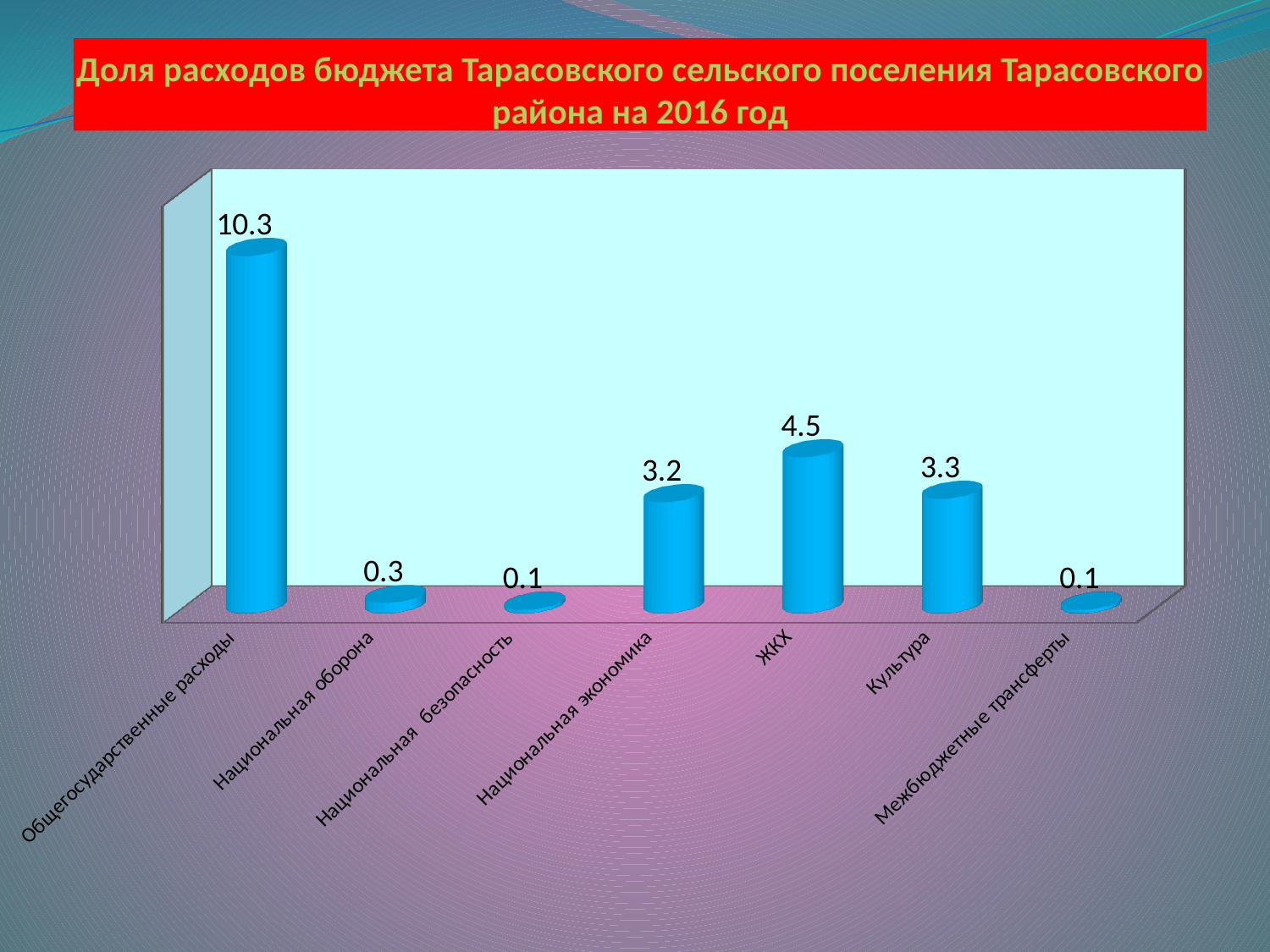
What is the value for Общегосударственные расходы? 10.3 What is the difference between the values for Общегосударственные расходы and ЖКХ? 5.8 What is the value for Национальная оборона? 0.3 What kind of chart is shown on the slide? Bar chart Which category has the highest value? Общегосударственные расходы What is the difference between the values for ЖКХ and Национальная экономика? 1.3 What is the value for Культура? 3.3 Which is larger, the value for ЖКХ or the value for Культура? ЖКХ What is the value for Национальная экономика? 3.2 What is the value for ЖКХ? 4.5 What is the value for Межбюджетные трансферты? 0.1 How many categories are shown on the chart? 7